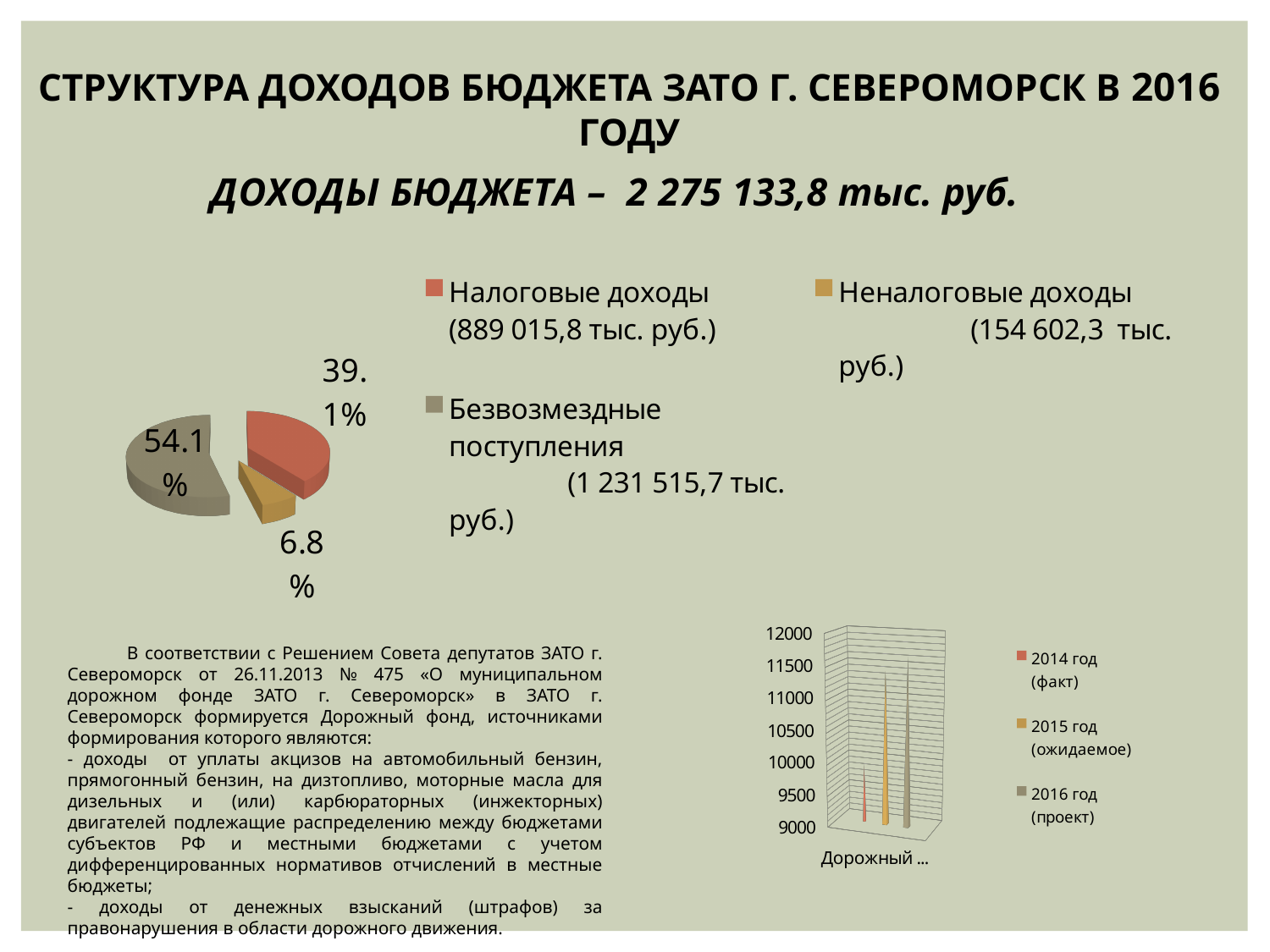
In the pie chart, which category has the smallest slice? Неналоговые доходы How many series does the legend of the bottom-right bar chart list? 3 In the pie chart, which category has the largest slice? Безвозмездные поступления How many slices does the pie chart have? 3 What kind of chart is the chart at the bottom right of the slide? Bar chart In the pie chart, what share of the budget revenue is Неналоговые доходы? 6.8% In the pie chart, which is larger: Налоговые доходы or Неналоговые доходы? Налоговые доходы In the pie chart, what share of the budget revenue is Безвозмездные поступления? 54.1% What kind of chart is the chart at the top left of the slide? Pie chart In the bottom-right bar chart, is the value for 2014 год (факт) greater or less than 11000? less In the pie chart, what is the difference in percentage points between Безвозмездные поступления and Налоговые доходы? 15.0% In the pie chart, what share of the budget revenue is Налоговые доходы? 39.1%